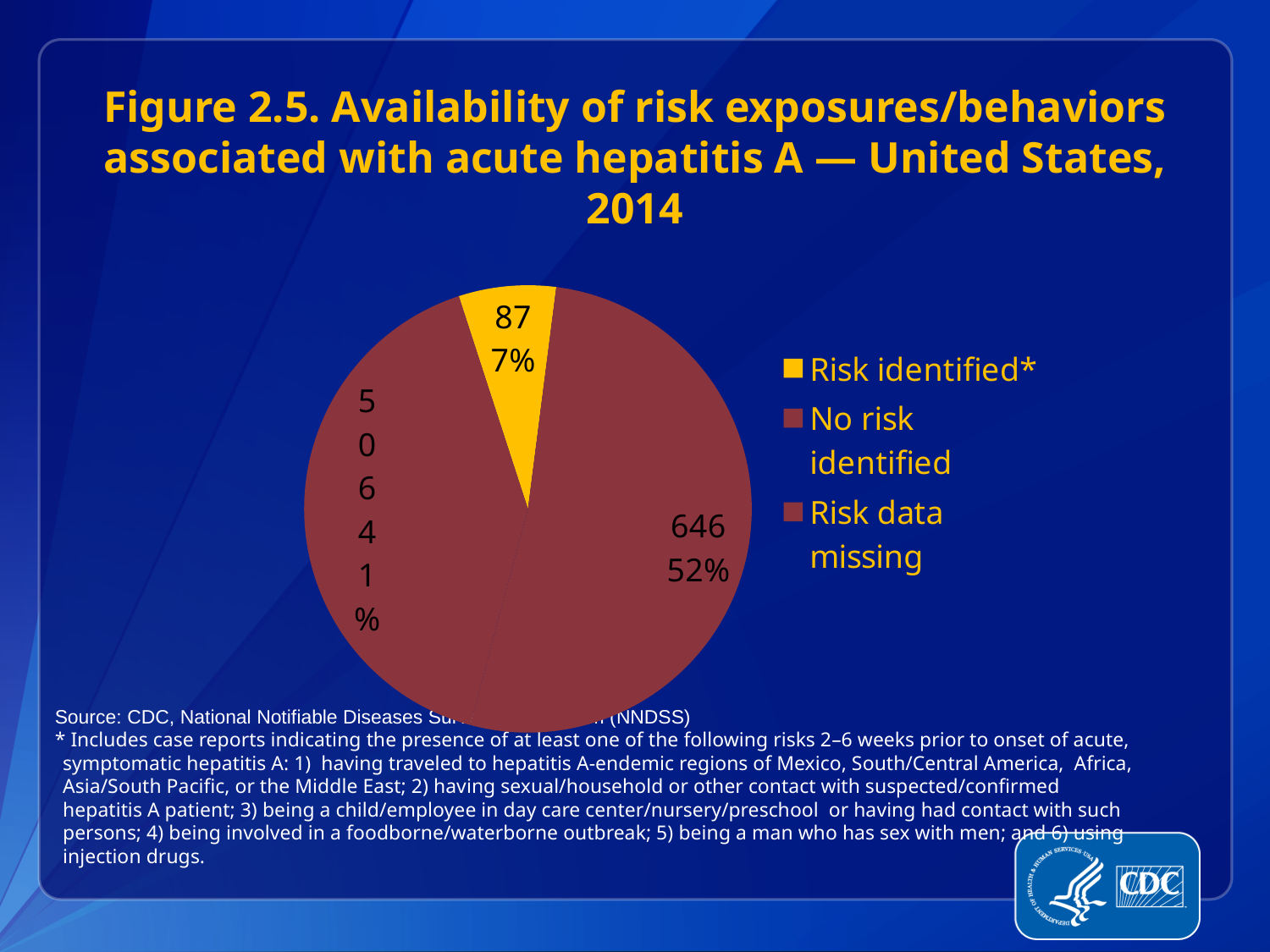
What is the difference between the number of cases in the largest slice (646) and the Risk identified* slice (87)? 559 How many slices does the pie chart have? 3 What percentage is shown on the largest slice of the pie? 52% What share of the pie does the Risk identified* slice represent? 7% What kind of chart is shown on the slide? pie chart How many entries does the legend list? 3 What colour is used for the Risk identified* slice? yellow Is the Risk identified* slice larger or smaller than the slice labeled 52%? smaller What is the number of cases shown on the largest slice of the pie? 646 Which legend category has the smallest slice of the pie? Risk identified* What number of cases is shown for the Risk identified* slice? 87 What year does the chart title say the data are for? 2014